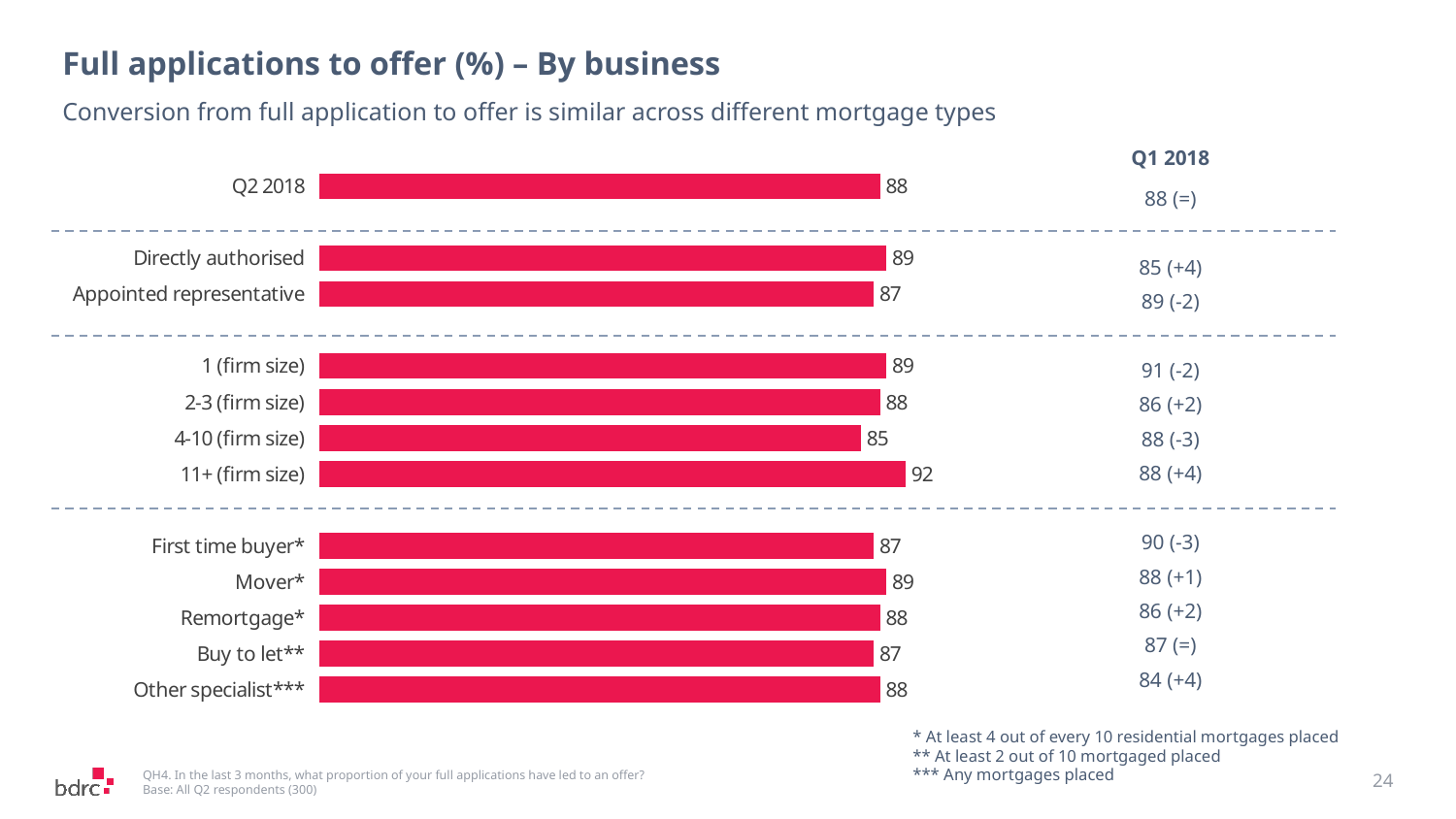
What is the difference between the values for 1 (firm size) and 2-3 (firm size)? 1 What is the title of the slide's chart? Full applications to offer (%) – By business What is the value for Appointed representative? 87 What is the value for 11+ (firm size)? 92 Which is larger, the value for Directly authorised or the value for Appointed representative? Directly authorised What is the difference between the values for 11+ (firm size) and 4-10 (firm size)? 7 How many bars are plotted in the chart? 12 What is the value for Other specialist***? 88 Which category has the highest value? 11+ (firm size) Which category has the lowest value? 4-10 (firm size) What kind of chart is shown on the slide? Bar chart What is the value for Mover*? 89